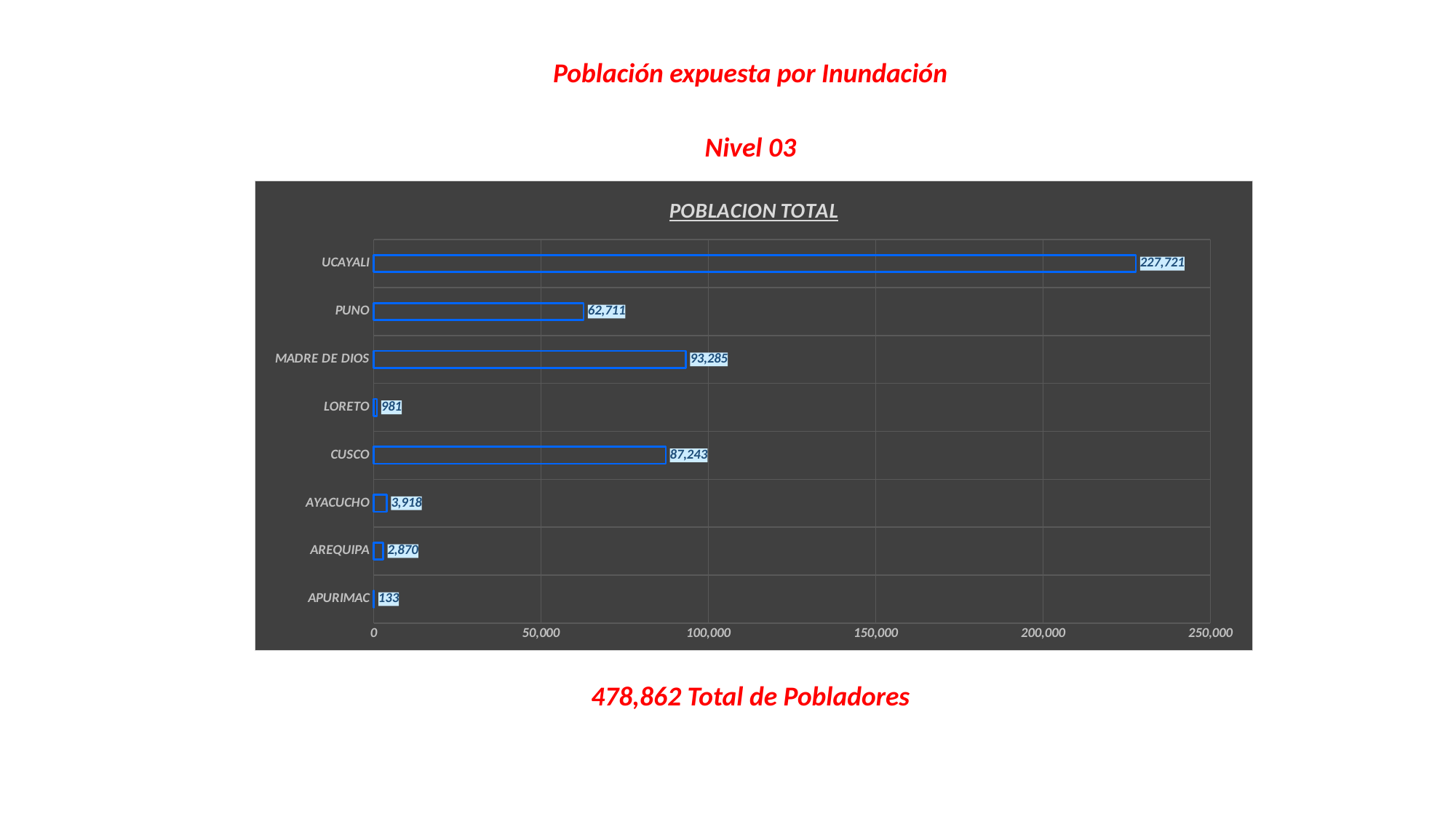
What is the value for UCAYALI? 227,721 Which category has the lowest value? APURIMAC What is the value for AYACUCHO? 3,918 What is the value for MADRE DE DIOS? 93,285 How many categories are shown in the chart? 8 What is the difference between the values for MADRE DE DIOS and CUSCO? 6,042 Which category has the highest value? UCAYALI What kind of chart is shown on the slide? bar chart What is the title of the chart? POBLACION TOTAL Is the value for UCAYALI greater or less than 200,000? greater What is the difference between the values for AYACUCHO and AREQUIPA? 1,048 Which is larger, the value for PUNO or the value for CUSCO? CUSCO